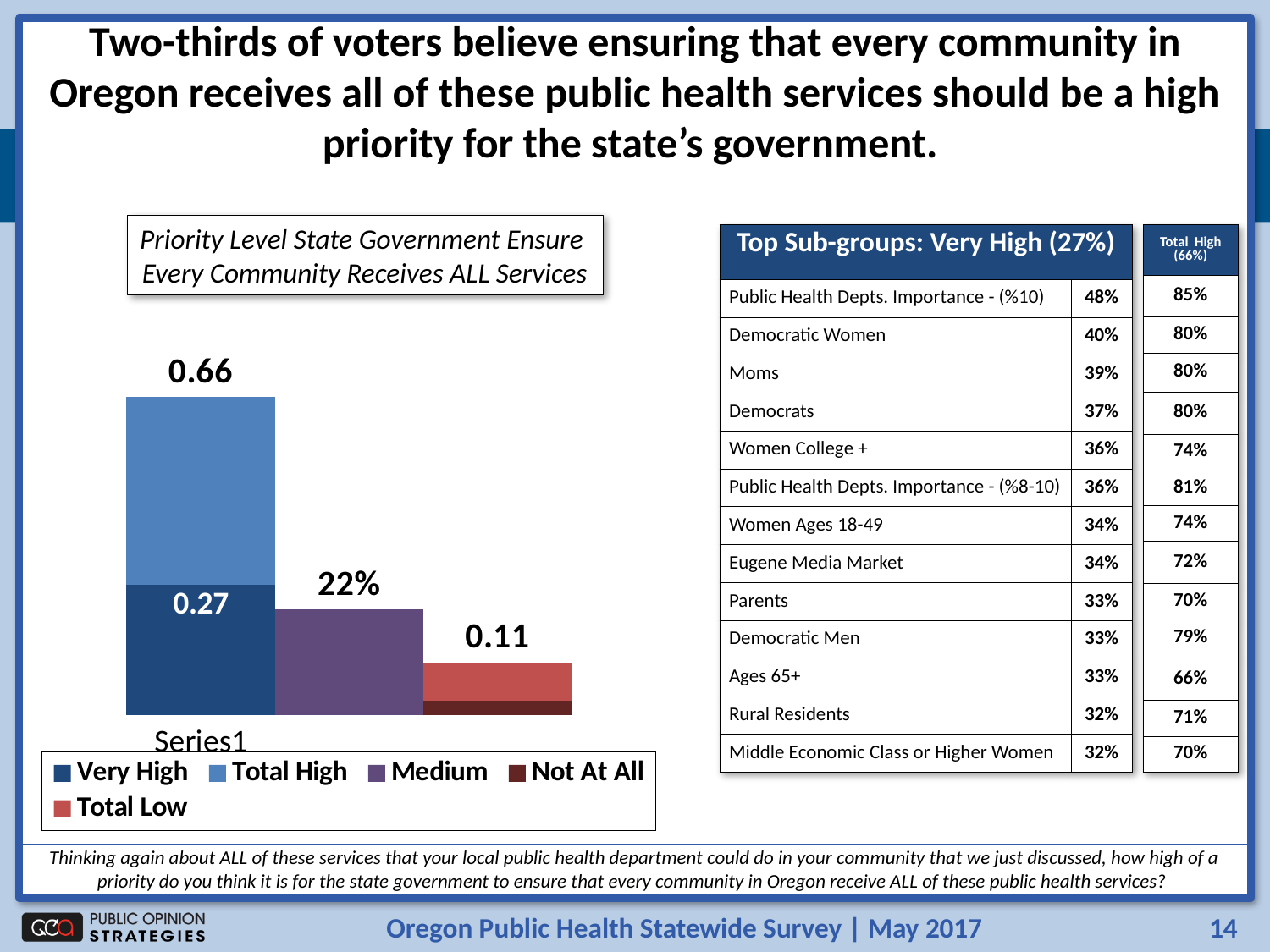
Which is larger in the chart, the Very High value or the Total Low value? Very High What is the title of the chart? Priority Level State Government Ensure Every Community Receives ALL Services What is the category label shown on the x axis of the chart? Series1 How many series does the chart legend list? 5 What is the difference between the Total High label (0.66) and the Very High label (0.27) in the chart? 0.39 What is the data label shown for the Very High series in the chart? 0.27 Which is larger in the chart, the Total High value or the Medium value? Total High Which labeled series in the chart has the highest value? Total High What is the data label shown for the Medium series in the chart? 22% What is the data label shown for the Total Low series in the chart? 0.11 What is the data label shown for the Total High series in the chart? 0.66 What kind of chart is shown on the slide? Bar chart